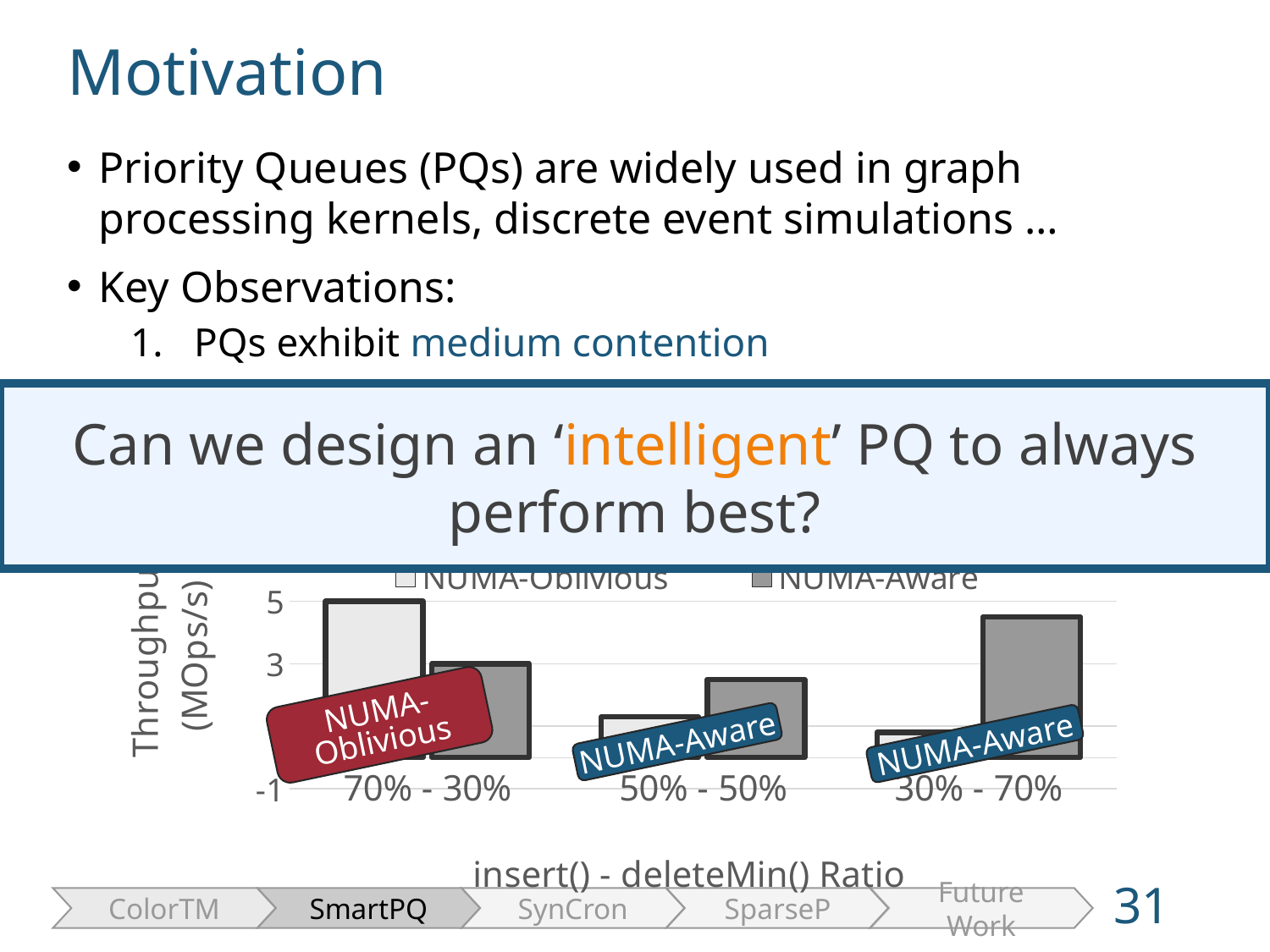
At the 30% - 70% ratio, which series has the larger throughput, NUMA-Oblivious or NUMA-Aware? NUMA-Aware What is the title of the x axis? insert() - deleteMin() Ratio Is the NUMA-Oblivious value at the 50% - 50% ratio greater or less than 3? less How many series does the chart's legend list? 2 For which ratio is the NUMA-Oblivious bar the highest? 70% - 30% At the 70% - 30% ratio, which series has the larger throughput, NUMA-Oblivious or NUMA-Aware? NUMA-Oblivious What kind of chart is shown on the slide? bar chart What are the two series named in the legend? NUMA-Oblivious and NUMA-Aware For which ratio is the NUMA-Aware bar the lowest? 50% - 50% For which ratio is the NUMA-Aware bar the highest? 30% - 70% How many insert() - deleteMin() ratio categories are shown on the x axis? 3 Is the NUMA-Aware value at the 30% - 70% ratio greater or less than 3? greater